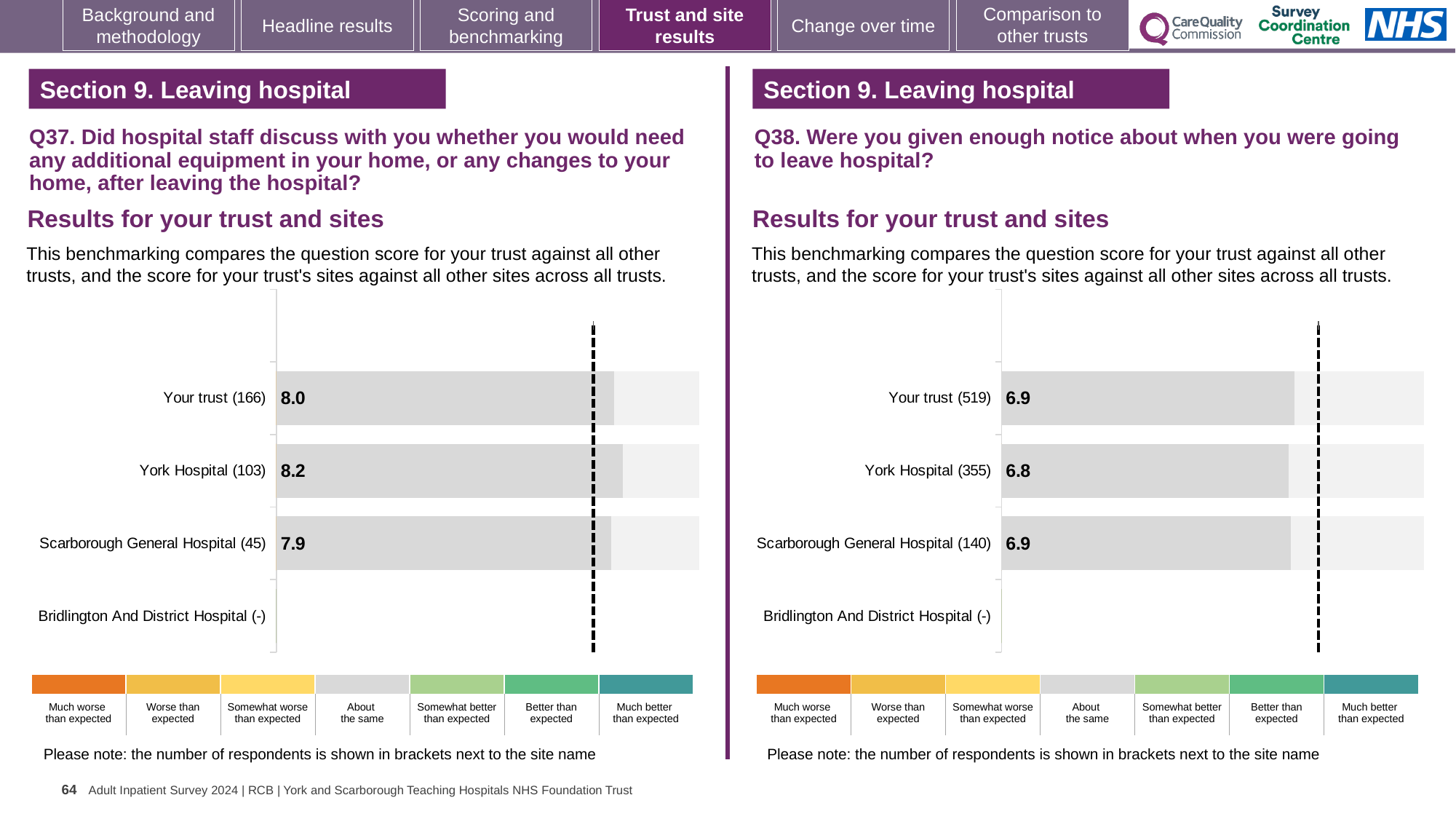
On the Q38 chart (right), what is the score for York Hospital? 6.8 On the Q38 chart (right), what is the difference between the Your trust score and the York Hospital score? 0.1 What kind of chart is used on the Q37 chart (left)? Bar chart On the Q37 chart (left), what is the score for Your trust? 8.0 On the Q38 chart (right), which is larger, the score for Your trust or the score for York Hospital? Your trust On the Q37 chart (left), what is the score for York Hospital? 8.2 On the Q37 chart (left), which site with a plotted score has the lowest score? Scarborough General Hospital On the Q37 chart (left), what is the difference between the York Hospital score and the Scarborough General Hospital score? 0.3 On the Q37 chart (left), which site has the highest score? York Hospital On the Q38 chart (right), what is the score for Your trust? 6.9 On the Q37 chart (left), what is the score for Scarborough General Hospital? 7.9 How many respondents are shown in brackets for Your trust on the Q38 chart (right)? 519